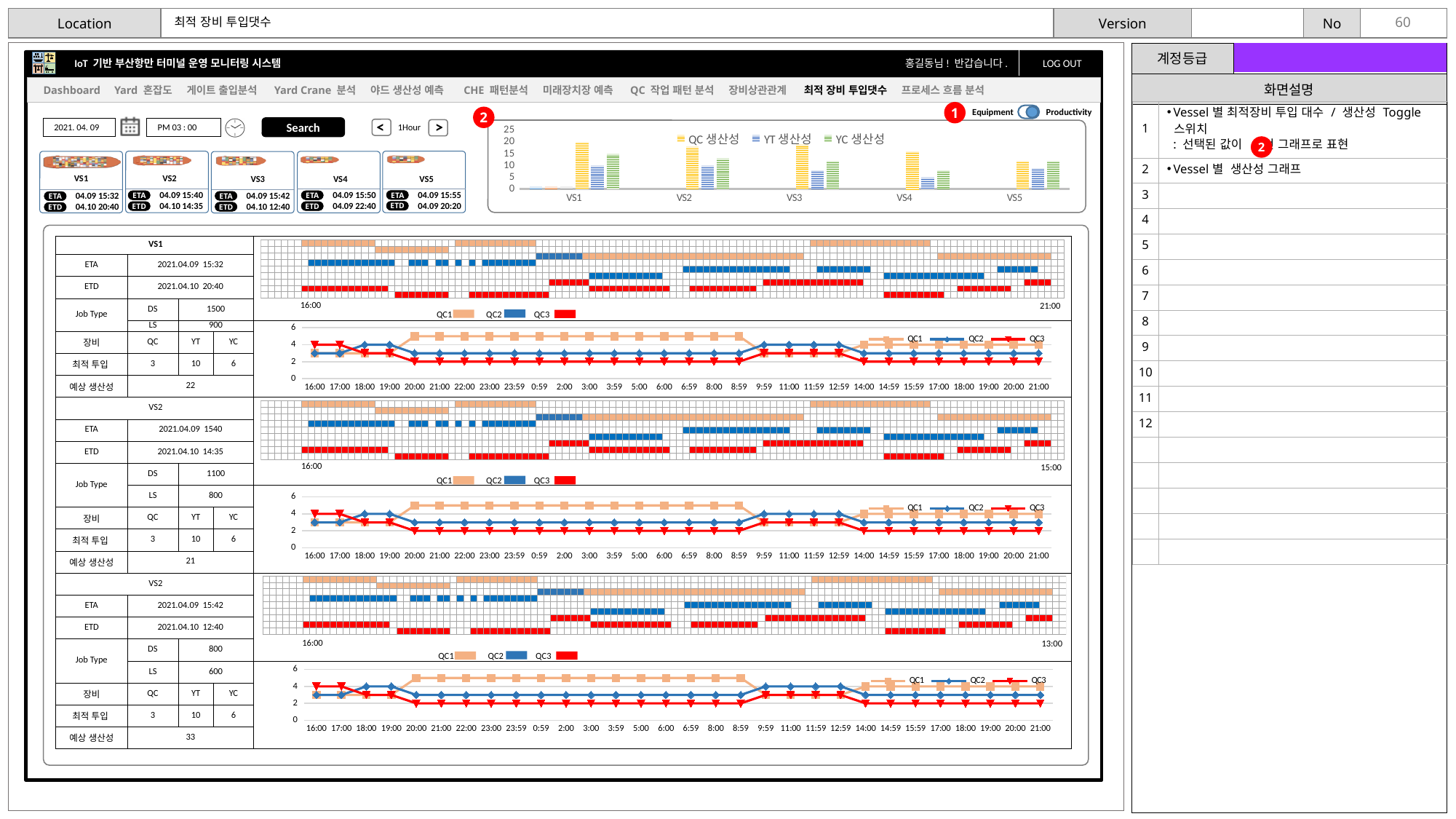
In the top bar chart (QC 생산성 / YT 생산성 / YC 생산성), how many series does the legend list? 3 In the top bar chart, how many vessel categories are shown on the x axis? 5 In the first line chart (for VS1, below the top bar chart), how many series does the legend list? 3 In the top bar chart, which series has the tallest bar for VS1? QC 생산성 In the top bar chart, is the YT 생산성 value for VS4 greater or less than 10? less In the top bar chart, what are the legend entries? QC 생산성, YT 생산성, YC 생산성 In the first line chart (for VS1), which is larger at 22:00, QC1 or QC3? QC1 In the first line chart (for VS1), is the QC1 value at 22:00 greater or less than 4? greater In the top bar chart, which vessel has the lowest YT 생산성 bar? VS4 In the top bar chart, is the QC 생산성 value for VS5 greater or less than 15? less What kind of chart is the top chart showing QC 생산성, YT 생산성 and YC 생산성 by vessel? bar chart